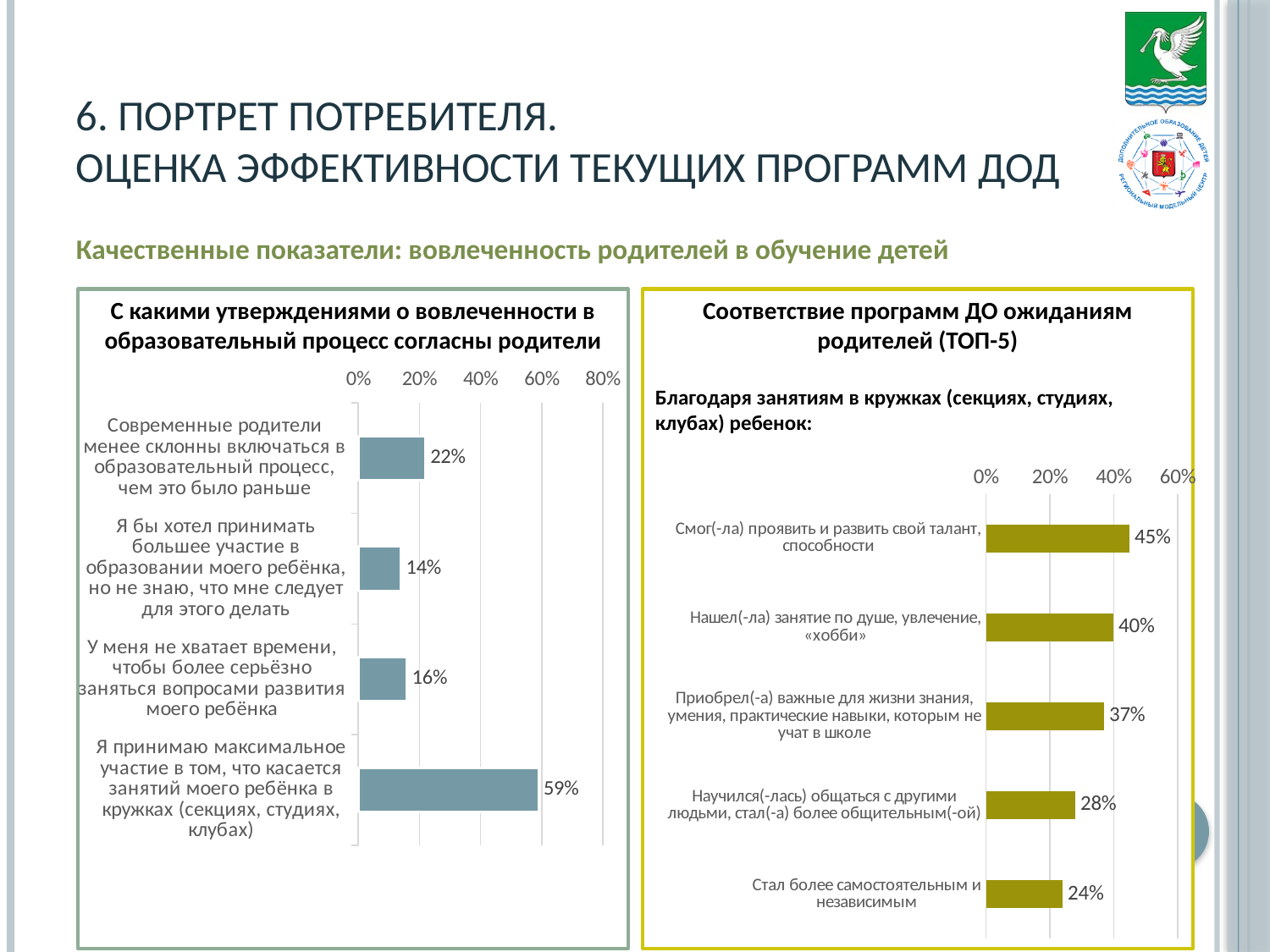
In the left chart, what is the value for "Современные родители менее склонны включаться в образовательный процесс, чем это было раньше"? 22% In the right chart (ТОП-5), which outcome has the highest value? Смог(-ла) проявить и развить свой талант, способности What type of chart is the right chart (ТОП-5)? Bar chart How many statements are shown in the left chart? 4 In the left chart, what percentage of parents agree with the statement "Я принимаю максимальное участие в том, что касается занятий моего ребёнка в кружках (секциях, студиях, клубах)"? 59% In the left chart, what is the difference between the highest value (59%) and the value for "У меня не хватает времени, чтобы более серьёзно заняться вопросами развития моего ребёнка"? 43% In the right chart (ТОП-5), which is larger: the value for "Приобрел(-а) важные для жизни знания, умения, практические навыки, которым не учат в школе" or for "Стал более самостоятельным и независимым"? Приобрел(-а) важные для жизни знания, умения, практические навыки, которым не учат в школе In the right chart (ТОП-5), what is the difference between "Нашел(-ла) занятие по душе, увлечение, «хобби»" and "Научился(-лась) общаться с другими людьми, стал(-а) более общительным(-ой)"? 12% In the left chart, which statement has the lowest share of agreeing parents? Я бы хотел принимать большее участие в образовании моего ребёнка, но не знаю, что мне следует для этого делать In the right chart (ТОП-5), what is the value for "Стал более самостоятельным и независимым"? 24% In the right chart (ТОП-5), what is the value for "Смог(-ла) проявить и развить свой талант, способности"? 45% In the right chart (ТОП-5), do the values rise or fall from the top category to the bottom category? Fall